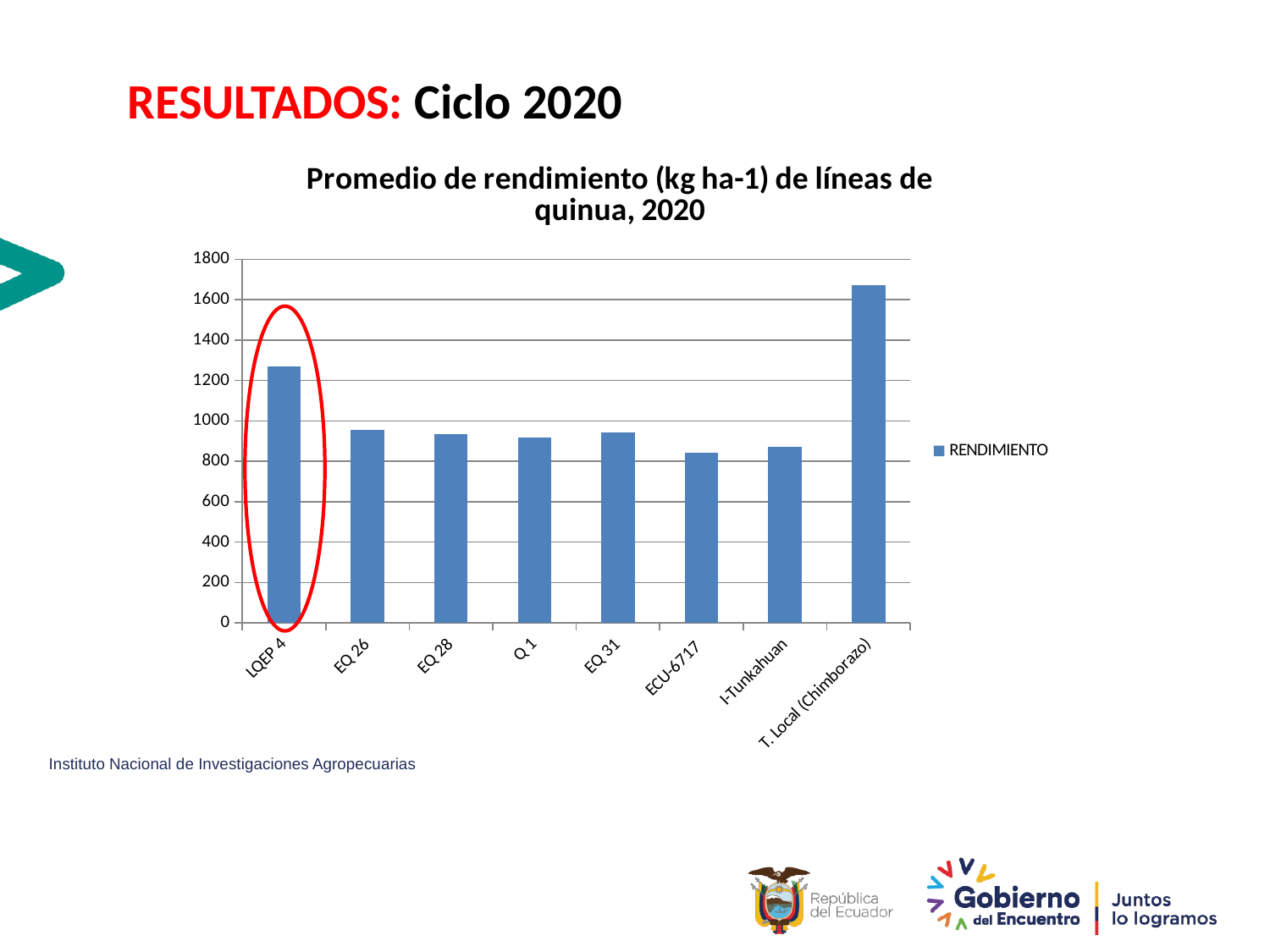
Which category's bar is circled in red on the chart? LQEP 4 Is the value for EQ 26 greater or less than 1000? less What is the name of the series shown in the legend? RENDIMIENTO What type of chart is shown on the slide? Bar chart Which category has the highest yield? T. Local (Chimborazo) Is the value for LQEP 4 greater or less than 1200? greater Is the value for T. Local (Chimborazo) greater or less than 1600? greater How many quinoa lines (categories) are plotted on the x axis? 8 Which has a higher yield, LQEP 4 or EQ 26? LQEP 4 Which has a higher yield, T. Local (Chimborazo) or LQEP 4? T. Local (Chimborazo) How many series does the legend list? 1